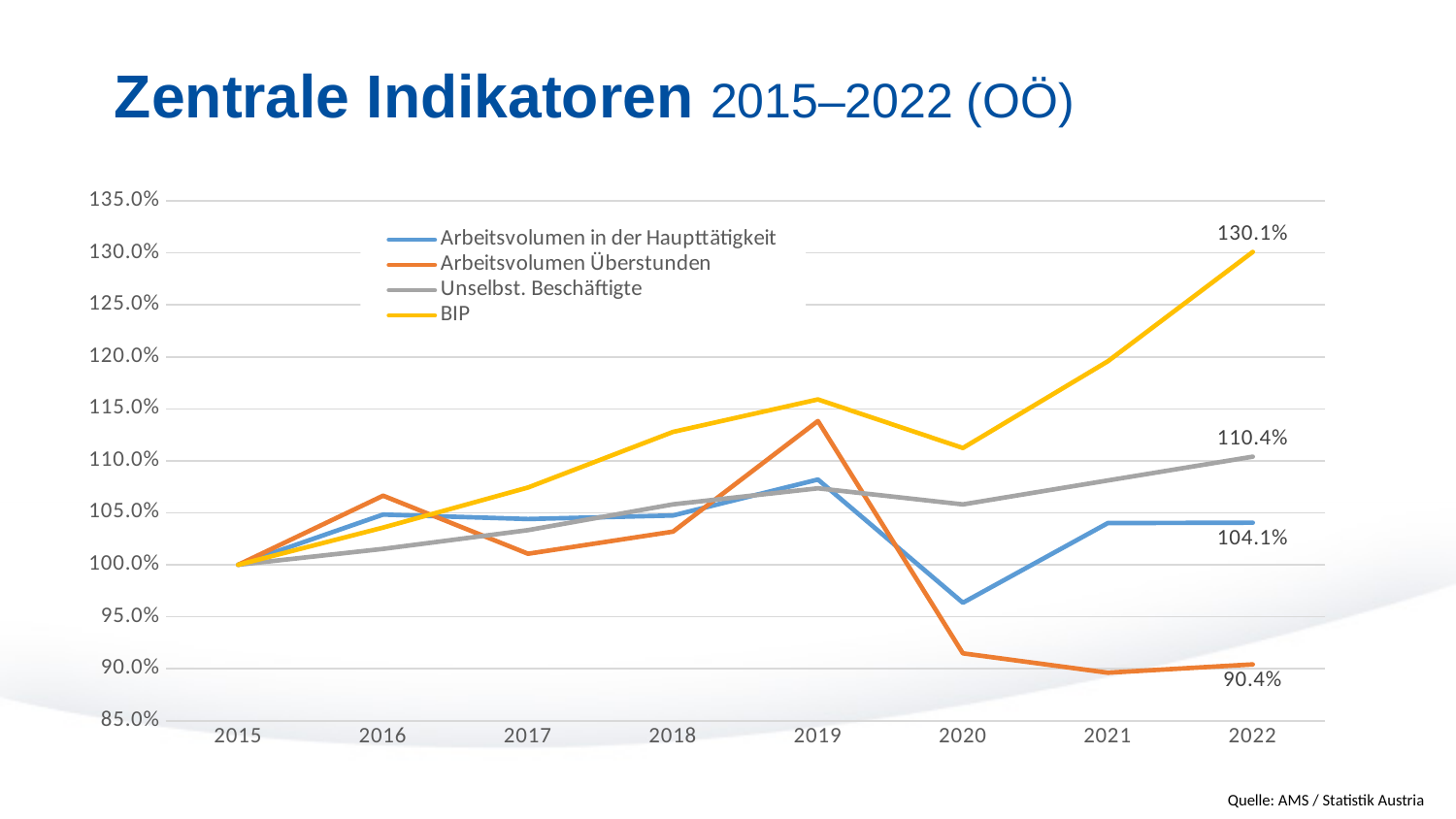
What is the difference between BIP and Unselbst. Beschäftigte in 2022? 19.7 percentage points Does the BIP line rise or fall from 2020 to 2022? rise What is the value of BIP in 2022? 130.1% How many series does the legend list? 4 How many years are shown on the x axis? 8 Which series has the highest value in 2022? BIP What is the value of Arbeitsvolumen Überstunden in 2022? 90.4% What kind of chart is shown on the slide? line chart What is the value of Arbeitsvolumen in der Haupttätigkeit in 2022? 104.1% Which series has the lowest value in 2022? Arbeitsvolumen Überstunden What is the value of Unselbst. Beschäftigte in 2022? 110.4% Is the value for Arbeitsvolumen Überstunden in 2020 greater or less than 95.0%? less